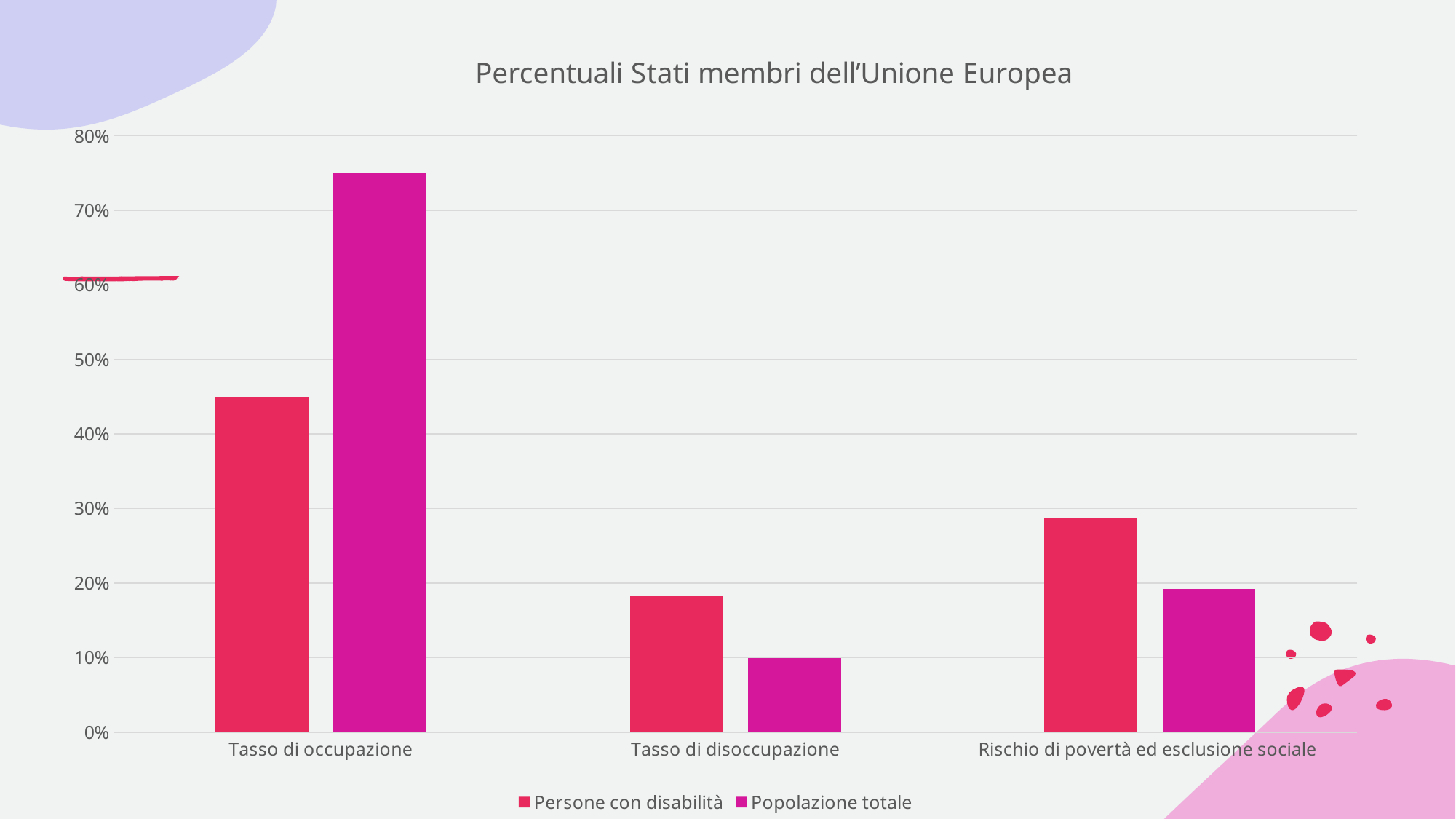
What is the title of the chart? Percentuali Stati membri dell'Unione Europea Which category has the highest value for Popolazione totale? Tasso di occupazione For Rischio di povertà ed esclusione sociale, which series has the larger value: Persone con disabilità or Popolazione totale? Persone con disabilità Which category has the lowest value for Popolazione totale? Tasso di disoccupazione How many series does the legend list? 2 What kind of chart is shown on the slide? bar chart Which series is shown in the darker magenta colour? Popolazione totale Is the value for Popolazione totale in Tasso di occupazione greater or less than 70%? greater Is the value for Persone con disabilità in Tasso di occupazione greater or less than 50%? less Which category has the lowest value for Persone con disabilità? Tasso di disoccupazione How many categories are shown on the x axis? 3 For Tasso di occupazione, which series has the larger value: Persone con disabilità or Popolazione totale? Popolazione totale